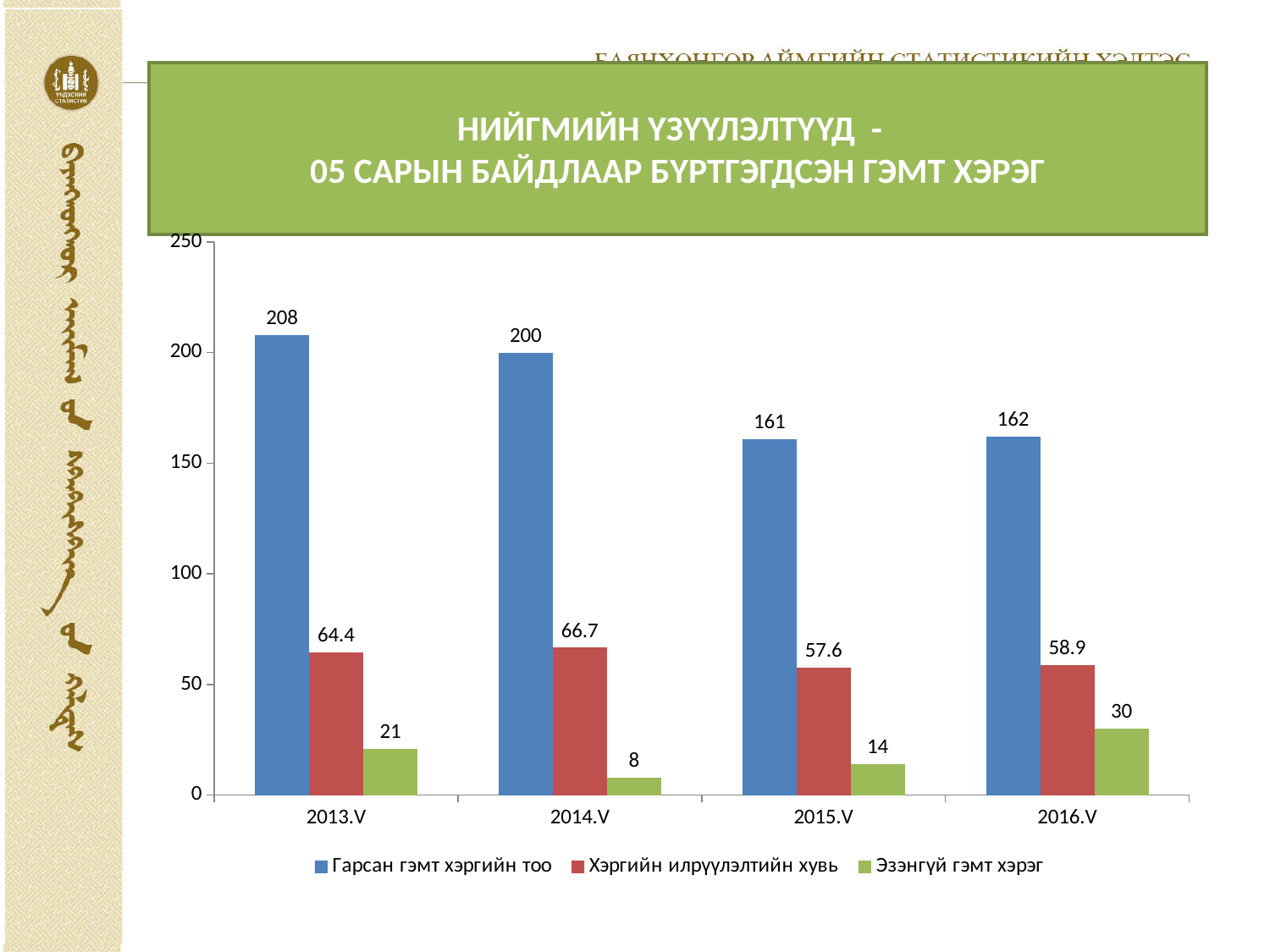
What is the value of Эзэнгүй гэмт хэрэг for 2016.V? 30 How many years are shown on the x axis? 4 What is the value of Хэргийн илрүүлэлтийн хувь for 2015.V? 57.6 What is the value of Гарсан гэмт хэргийн тоо for 2013.V? 208 What kind of chart is shown on the slide? bar chart What is the difference between Гарсан гэмт хэргийн тоо in 2013.V and 2014.V? 8 In which year is Эзэнгүй гэмт хэрэг the lowest? 2014.V In which year is Гарсан гэмт хэргийн тоо the highest? 2013.V What colour are the bars for Эзэнгүй гэмт хэрэг? green How many series does the legend list? 3 Is the value of Гарсан гэмт хэргийн тоо for 2015.V greater or less than 200? less Which is larger: Хэргийн илрүүлэлтийн хувь in 2014.V or in 2016.V? 2014.V